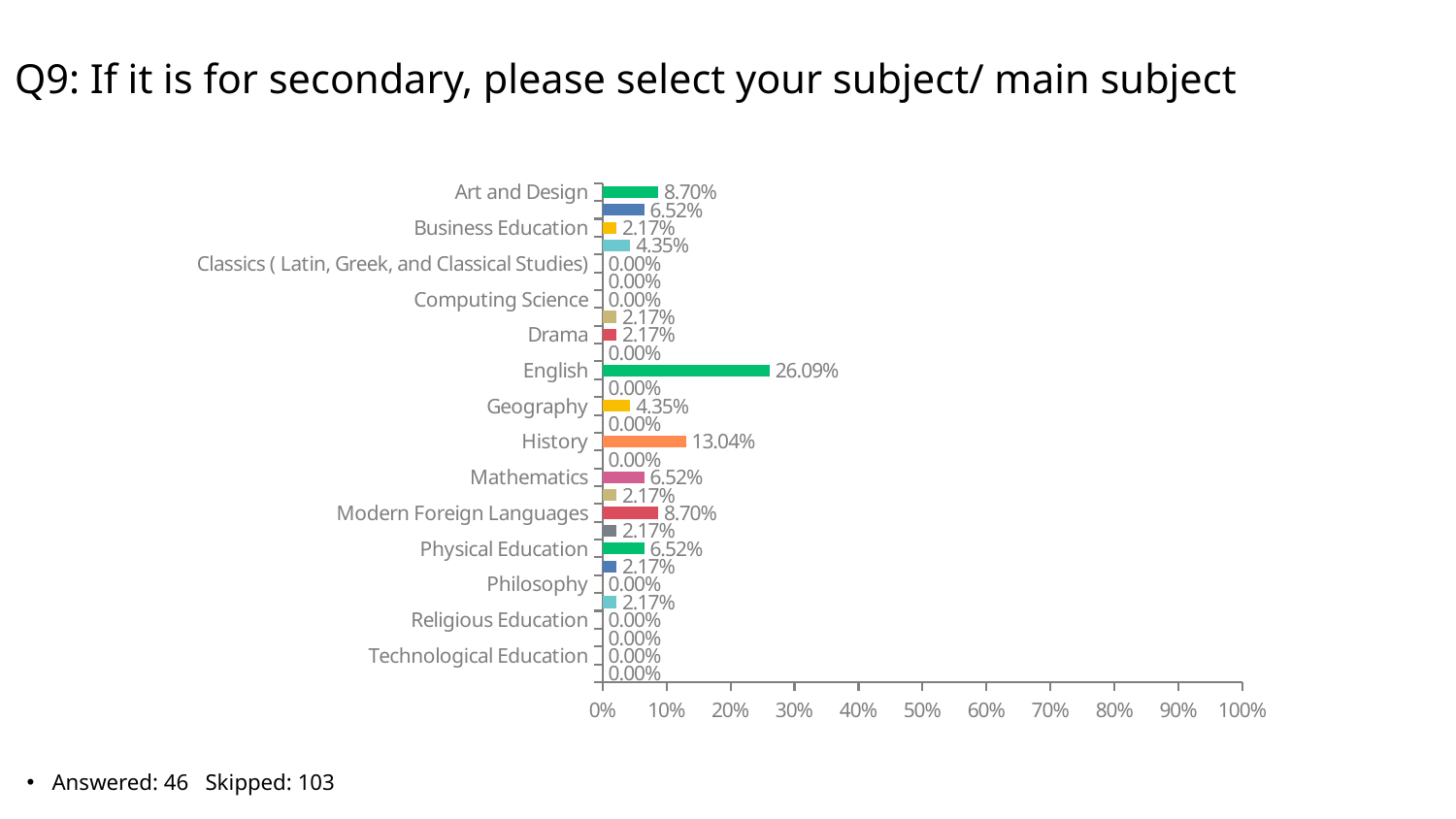
What is the value for Art and Design? 8.70% What kind of chart is shown on the slide? bar chart Which subject has the highest value? English What is the value for Geography? 4.35% What is the value for History? 13.04% Is the value for English greater or less than 20%? greater What is the difference between the values for Art and Design and Business Education? 6.53% Which is larger, the value for Modern Foreign Languages or the value for Mathematics? Modern Foreign Languages What is the value for Drama? 2.17% What is the value for Technological Education? 0.00% What is the difference between the values for English and History? 13.05% What is the value for English? 26.09%